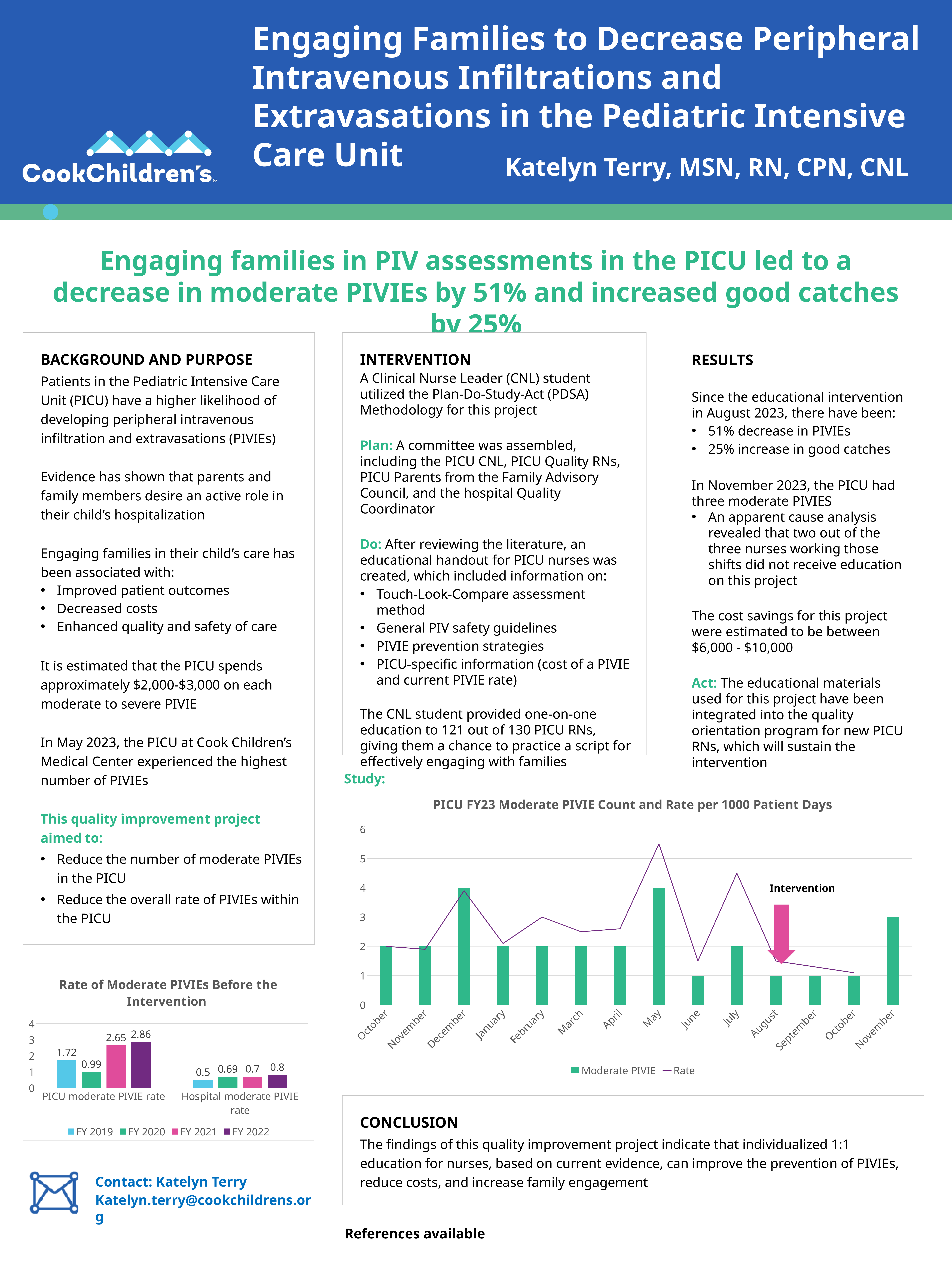
In the 'Rate of Moderate PIVIEs Before the Intervention' chart, how many series does the legend list? 4 In the 'Rate of Moderate PIVIEs Before the Intervention' chart, what is the PICU moderate PIVIE rate for FY 2019? 1.72 In the 'Rate of Moderate PIVIEs Before the Intervention' chart, is the FY 2021 PICU moderate PIVIE rate larger or smaller than the FY 2021 Hospital moderate PIVIE rate? larger In the 'PICU FY23 Moderate PIVIE Count and Rate per 1000 Patient Days' chart, what is the Moderate PIVIE count for the final November? 3 In the 'PICU FY23 Moderate PIVIE Count and Rate per 1000 Patient Days' chart, in which month does the Rate line reach its highest point? May In the 'PICU FY23 Moderate PIVIE Count and Rate per 1000 Patient Days' chart, is the Rate value for May greater or less than 5? greater In the 'Rate of Moderate PIVIEs Before the Intervention' chart, which fiscal year has the lowest PICU moderate PIVIE rate? FY 2020 In the 'Rate of Moderate PIVIEs Before the Intervention' chart, which fiscal year has the highest PICU moderate PIVIE rate? FY 2022 In the 'PICU FY23 Moderate PIVIE Count and Rate per 1000 Patient Days' chart, what is the Moderate PIVIE count for December? 4 In the 'Rate of Moderate PIVIEs Before the Intervention' chart, what is the Hospital moderate PIVIE rate for FY 2022? 0.8 How many months are shown on the x axis of the 'PICU FY23 Moderate PIVIE Count and Rate per 1000 Patient Days' chart? 14 In the 'Rate of Moderate PIVIEs Before the Intervention' chart, what is the difference between the FY 2022 and FY 2019 PICU moderate PIVIE rates? 1.14